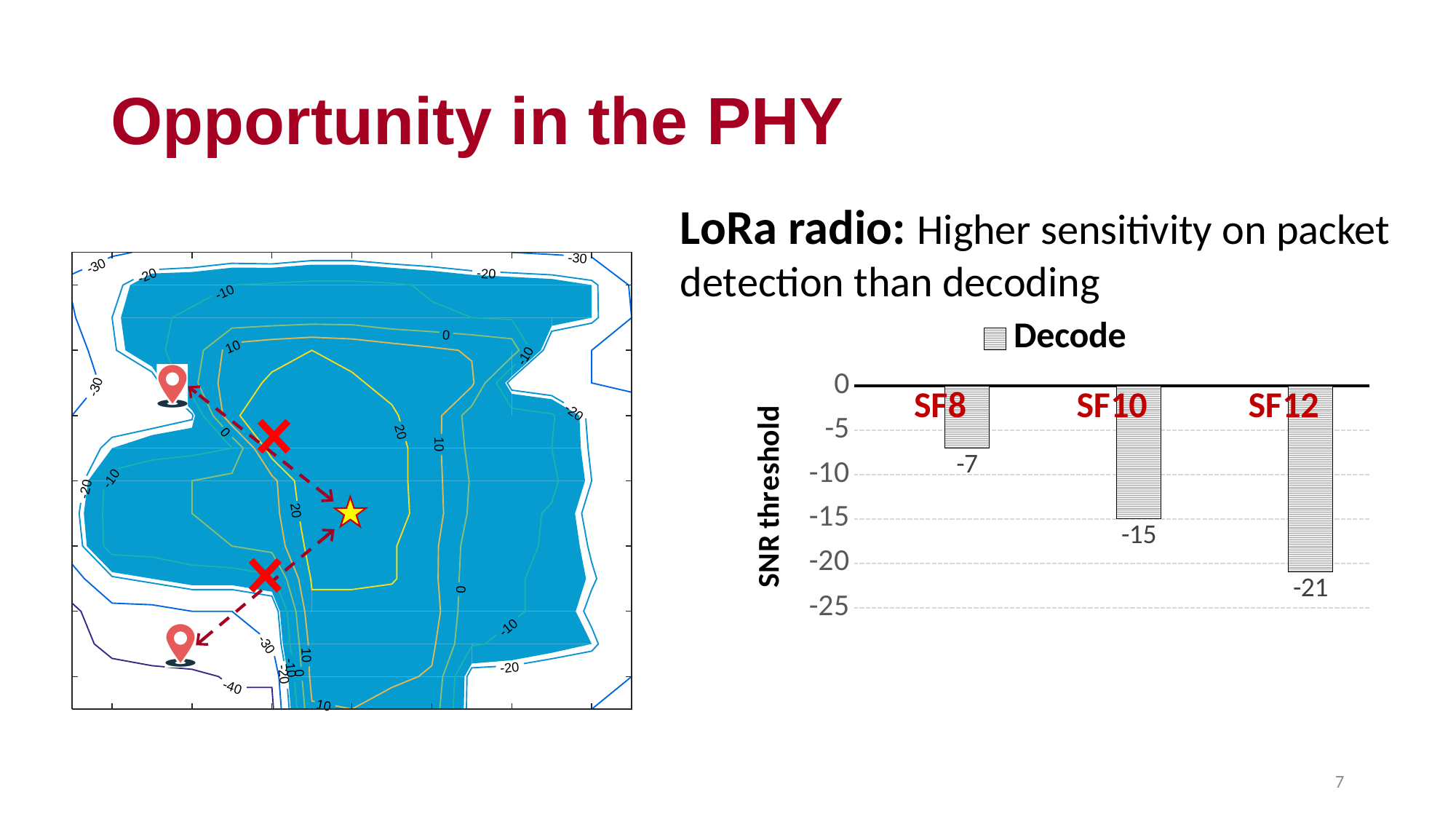
In the SNR threshold bar chart, is the Decode value for SF12 greater or less than -20? less What type of chart is the SNR threshold chart on the right of the slide? Bar chart In the SNR threshold bar chart, what is the Decode value for SF10? -15 In the SNR threshold bar chart, which spreading factor has the highest Decode SNR threshold? SF8 In the SNR threshold bar chart, what is the difference between the Decode values for SF10 and SF12? 6 In the SNR threshold bar chart, what is the Decode value for SF12? -21 In the SNR threshold bar chart, which has a higher Decode SNR threshold, SF8 or SF10? SF8 In the SNR threshold bar chart, what is the difference between the Decode values for SF8 and SF12? 14 How many series does the legend of the SNR threshold chart list? 1 How many spreading factor categories are shown in the SNR threshold bar chart? 3 In the SNR threshold bar chart, what is the Decode value for SF8? -7 In the SNR threshold bar chart, which spreading factor has the lowest (most negative) Decode SNR threshold? SF12